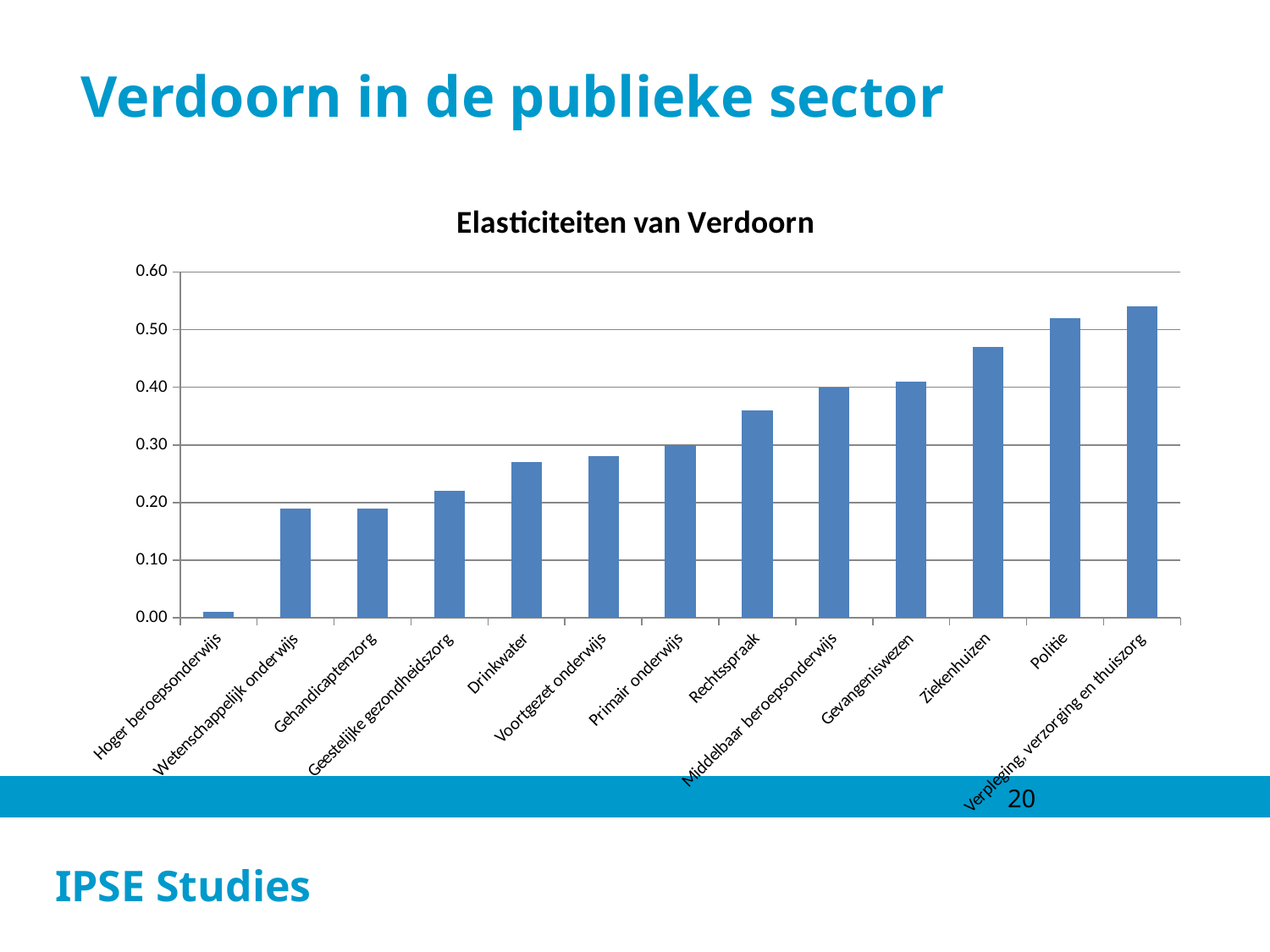
How many categories are plotted in the chart? 13 Do the values rise or fall from left to right along the x axis? rise Which category has the lowest value? Hoger beroepsonderwijs Is the value for Rechtspraak greater or less than 0.30? greater What kind of chart is shown on the slide? bar chart Is the value for Ziekenhuizen greater or less than 0.50? less Is the value for Drinkwater greater or less than 0.30? less What is the title of the chart? Elasticiteiten van Verdoorn Which category has the highest value? Verpleging, verzorging en thuiszorg Which has the larger value, Politie or Drinkwater? Politie